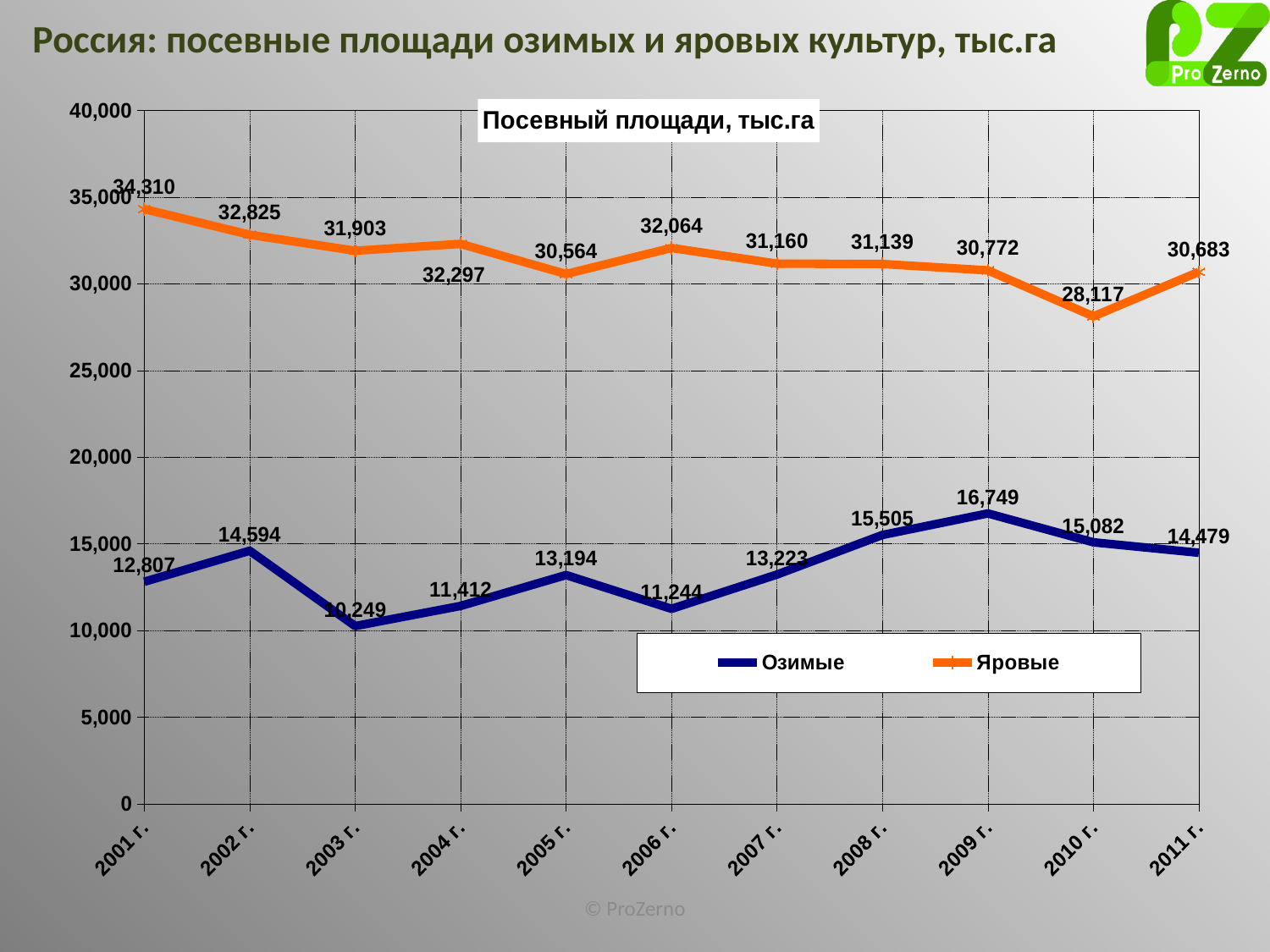
What kind of chart is shown on the slide? line chart Is the value for Яровые in 2010 г. greater or less than 30,000? less Which is larger: the Озимые value in 2002 г. or in 2005 г.? 2002 г. What is the value for Озимые in 2009 г.? 16,749 What is the difference between the Яровые and Озимые values in 2011 г.? 16,204 What is the value for Озимые in 2003 г.? 10,249 In which year is the Яровые series highest? 2001 г. In which year is the Озимые series lowest? 2003 г. How many years are shown on the x axis? 11 Does the Яровые series generally rise or fall from 2001 г. to 2010 г.? fall What is the value for Яровые in 2010 г.? 28,117 How many series does the legend list? 2